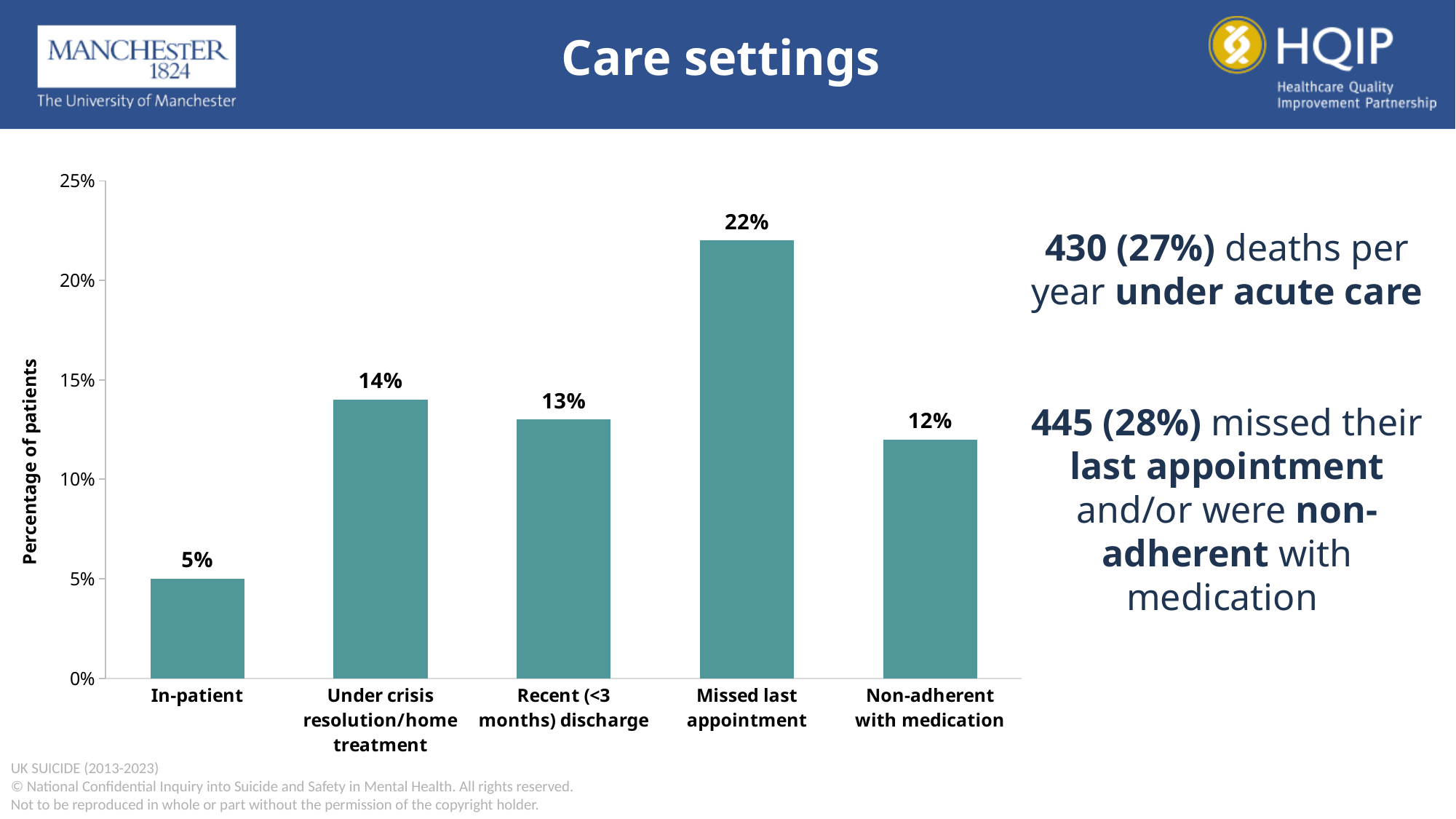
Is the value for 'Missed last appointment' greater or less than 20%? greater What percentage of patients were in-patients? 5% What is the difference in percentage points between 'Missed last appointment' and 'In-patient'? 17 percentage points What percentage of patients were under crisis resolution/home treatment? 14% Which is larger: the percentage for 'Under crisis resolution/home treatment' or for 'Non-adherent with medication'? Under crisis resolution/home treatment What type of chart is shown on the slide? Bar chart How many care setting categories are shown on the chart? 5 What is the label of the vertical axis of the chart? Percentage of patients Which care setting category has the lowest percentage of patients? In-patient What percentage of patients had a recent (<3 months) discharge? 13% Which care setting category has the highest percentage of patients? Missed last appointment What percentage of patients were non-adherent with medication? 12%